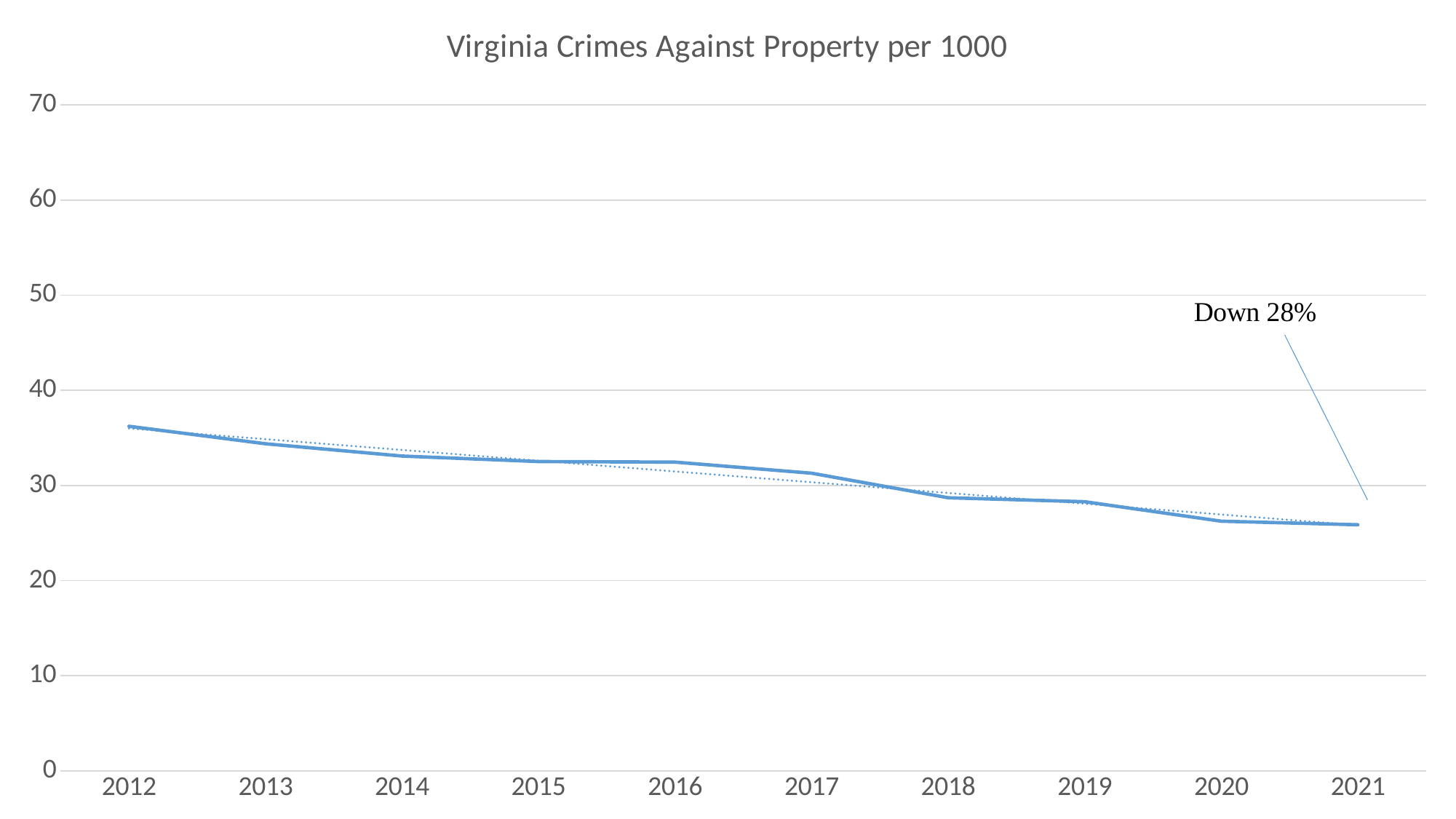
Which year has the larger value, 2017 or 2020? 2017 How many years are plotted along the x axis? 10 Is the value for 2012 greater or less than 40? less Which year has the lowest value? 2021 Which year has the highest value? 2012 Is the value for 2020 greater or less than 20? greater Is the value for 2021 greater or less than 30? less What is the title of the chart? Virginia Crimes Against Property per 1000 What kind of chart is shown on the slide? Line chart What does the annotation on the chart say about the overall change? Down 28% Do the values rise or fall from 2012 to 2021? Fall